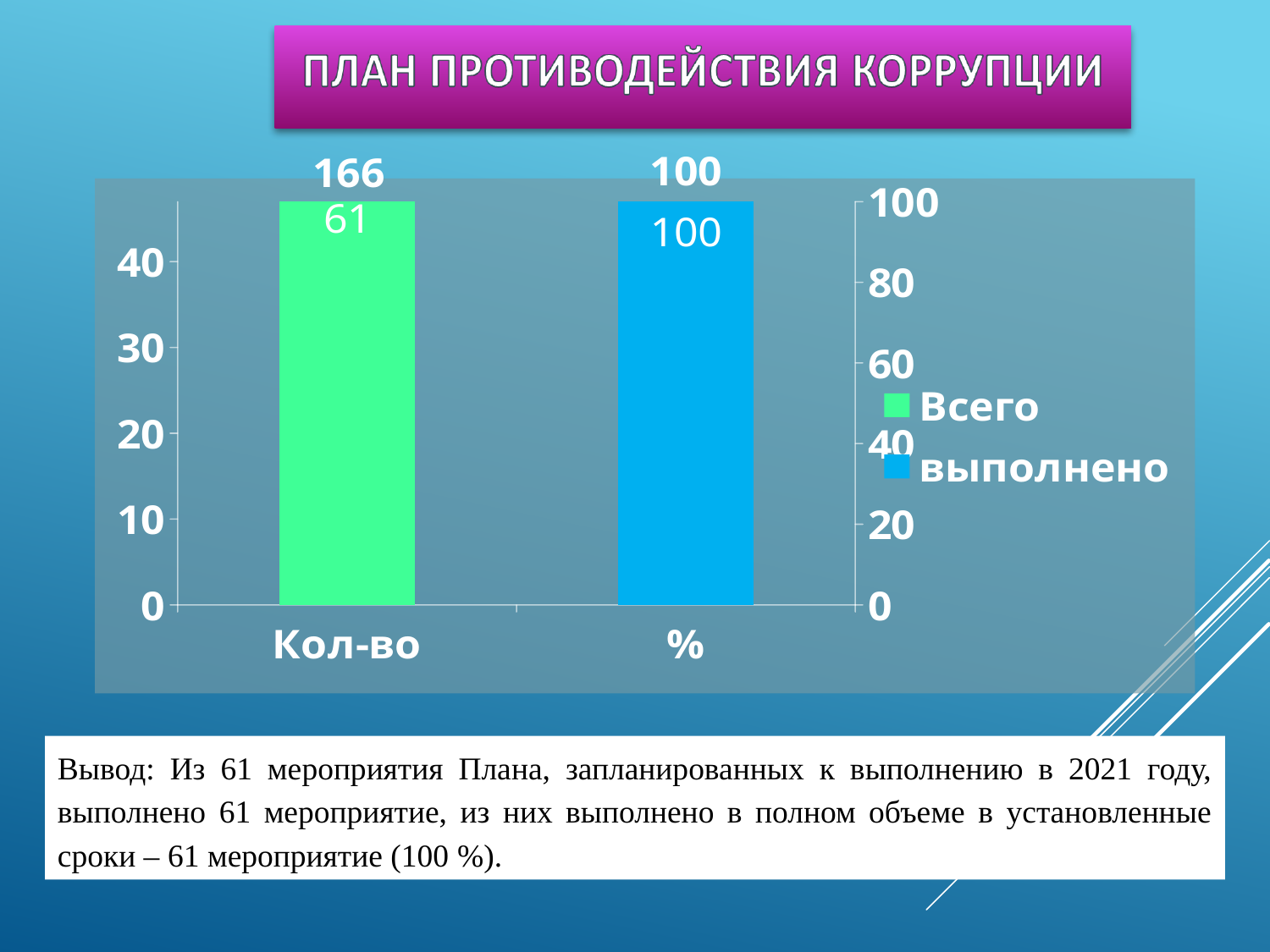
How many series does the chart legend list? 2 Which legend entry is shown in green? Всего How many bars are plotted in the chart? 2 What value is printed inside the % bar? 100 What value is printed inside the Кол-во bar? 61 What is the highest tick value shown on the right-hand axis of the chart? 100 What are the two category labels on the x axis of the chart? Кол-во and % Is the Кол-во bar greater or less than 40 on the left axis? greater What kind of chart is shown on the slide? bar chart What is the highest tick value shown on the left-hand axis of the chart? 40